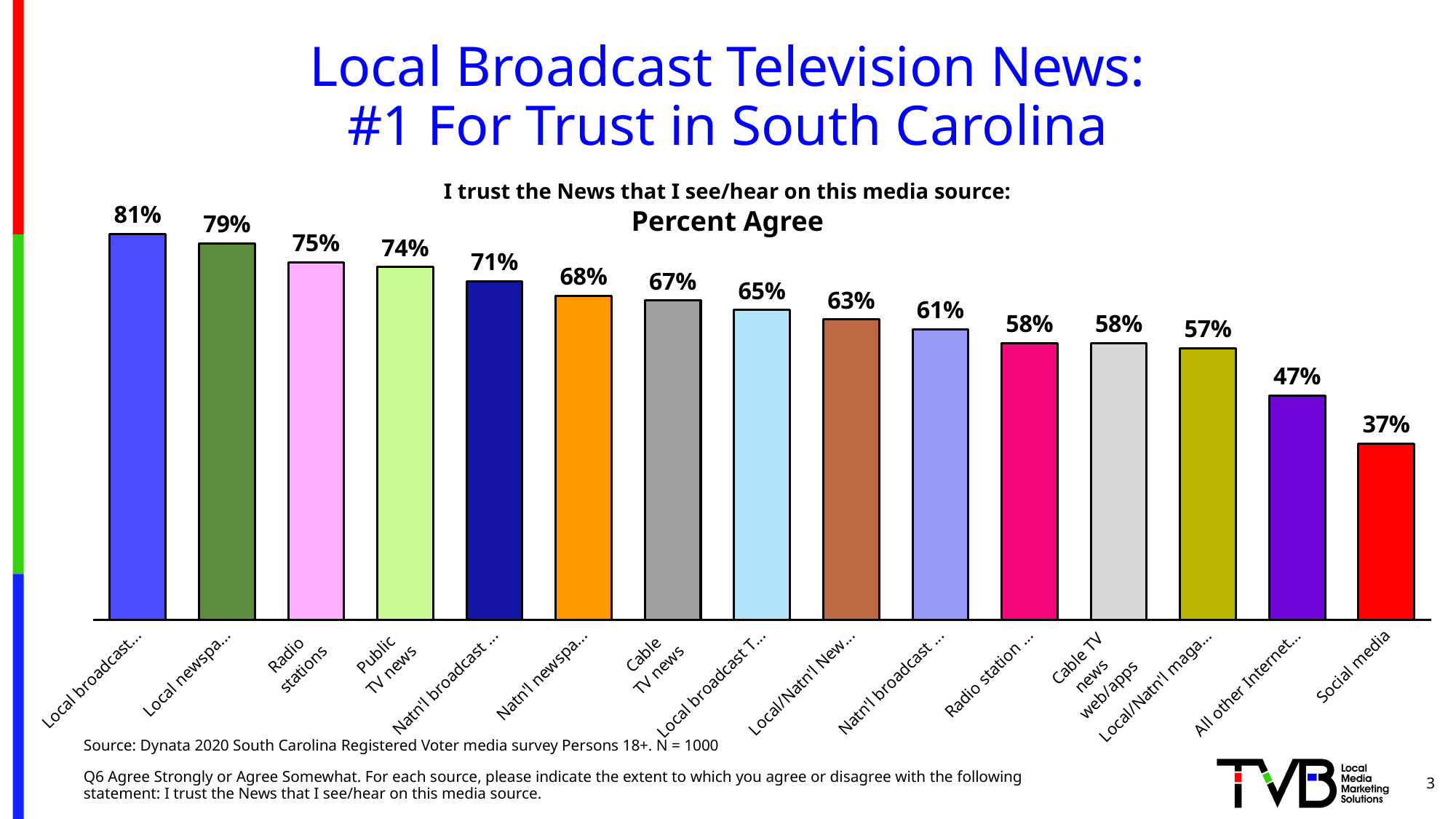
What is the value shown for Cable TV news? 67% What percent agree that they trust the news on Radio stations? 75% What is the value shown for Cable TV news web/apps? 58% What is the difference in percentage points between Cable TV news and Cable TV news web/apps? 9 percentage points What is the value shown for Public TV news? 74% What is the value shown for Social media? 37% What is the highest value shown on the chart? 81% Which has a higher value, Radio stations or Cable TV news? Radio stations How many bars are shown on the chart? 15 What kind of chart is shown on the slide? Bar chart Which media source has the lowest percent agree? Social media Do the values rise or fall from left to right across the chart? Fall